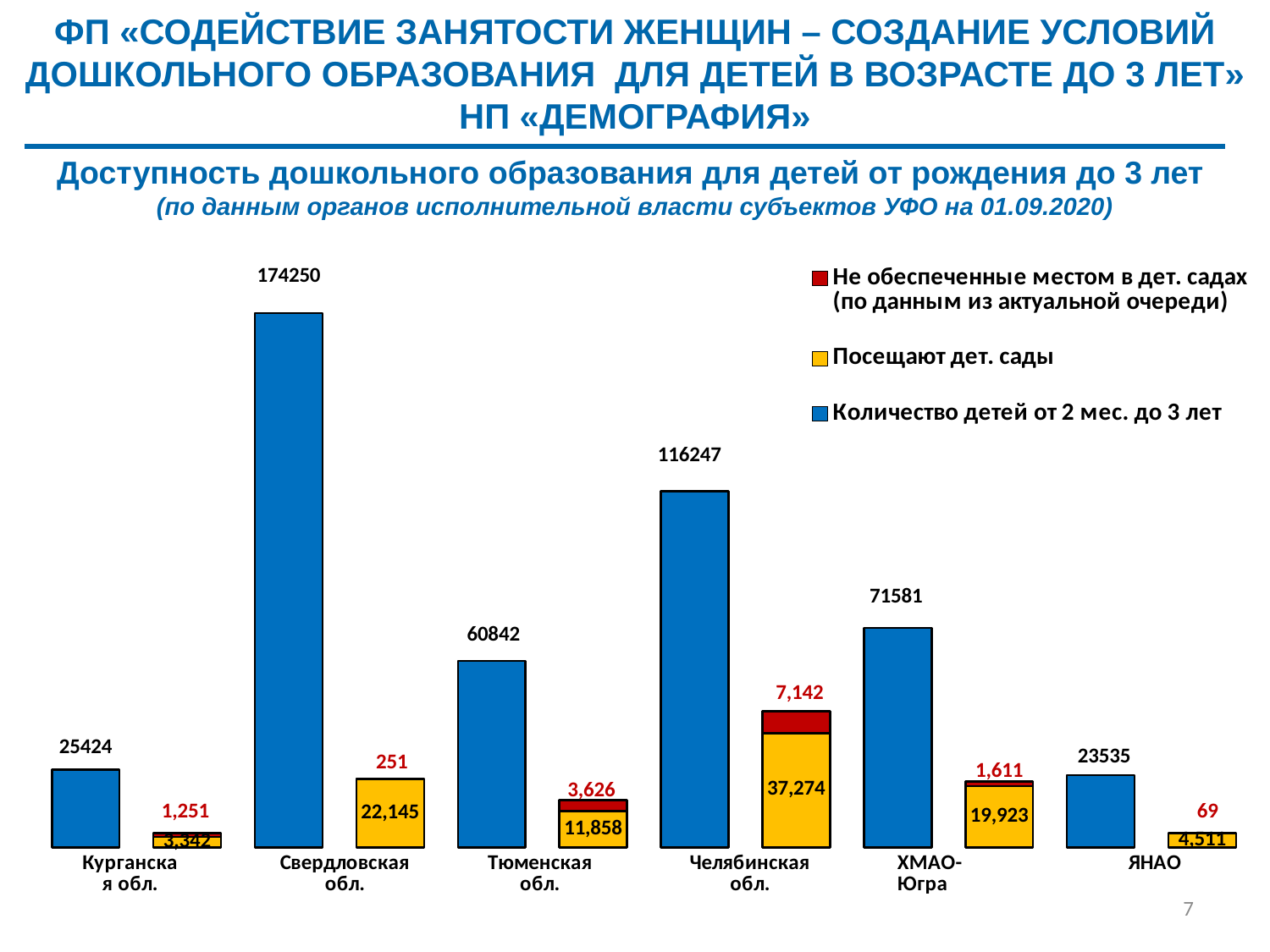
What is the total of the stacked bar (attending plus not provided a place) for ХМАО-Югра? 21,534 Which is larger: the number of children attending kindergartens in ХМАО-Югра or in Тюменская обл.? ХМАО-Югра What kind of chart is shown on the slide? Bar chart Which colour represents the series 'Посещают дет. сады' in the legend? Yellow How many children attend kindergartens (Посещают дет. сады) in Челябинская обл.? 37,274 How many regions are shown on the x axis of the chart? 6 What is the difference between the number of children from 2 months to 3 years in Челябинская обл. and in ХМАО-Югра? 44666 What is the number of children from 2 months to 3 years (Количество детей от 2 мес. до 3 лет) in Свердловская обл.? 174250 How many series does the legend list? 3 Which region has the highest number of children from 2 months to 3 years? Свердловская обл. Which region has the lowest value for children not provided a kindergarten place? ЯНАО What is the value for children not provided a kindergarten place (Не обеспеченные местом) in Тюменская обл.? 3,626